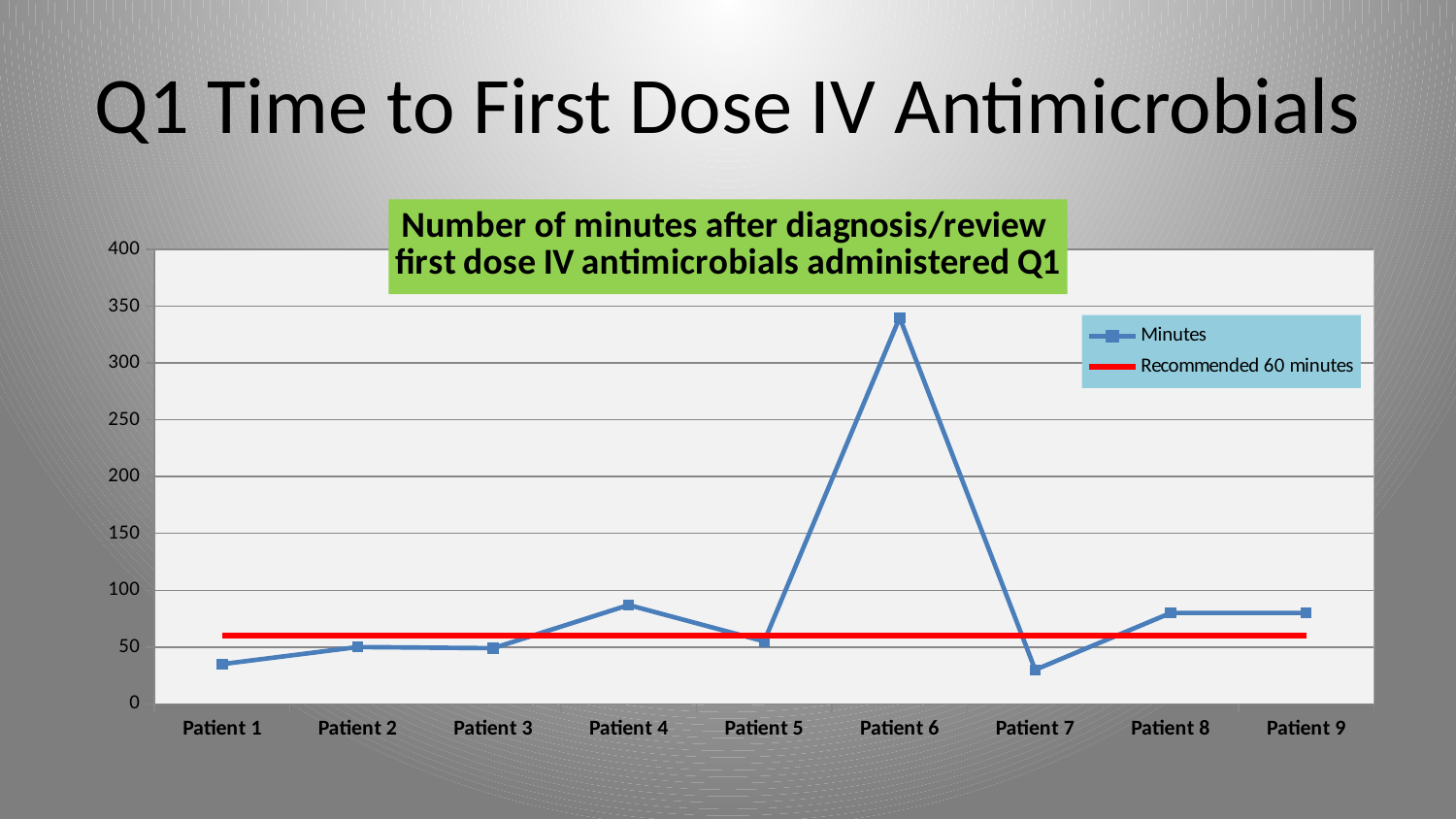
Is the value for Patient 8 greater or less than 100? less How many patients are shown on the x axis of the chart? 9 Is the value for Patient 1 greater or less than 50? less Which has a larger value, Patient 6 or Patient 4? Patient 6 Is the value for Patient 6 greater or less than 300? greater How many series does the chart's legend list? 2 What kind of chart is shown on the slide? Line chart Which patient has the highest number of minutes to first dose IV antimicrobials? Patient 6 What does the red horizontal line on the chart represent, according to the legend? Recommended 60 minutes Does the Minutes line rise or fall from Patient 6 to Patient 7? Fall